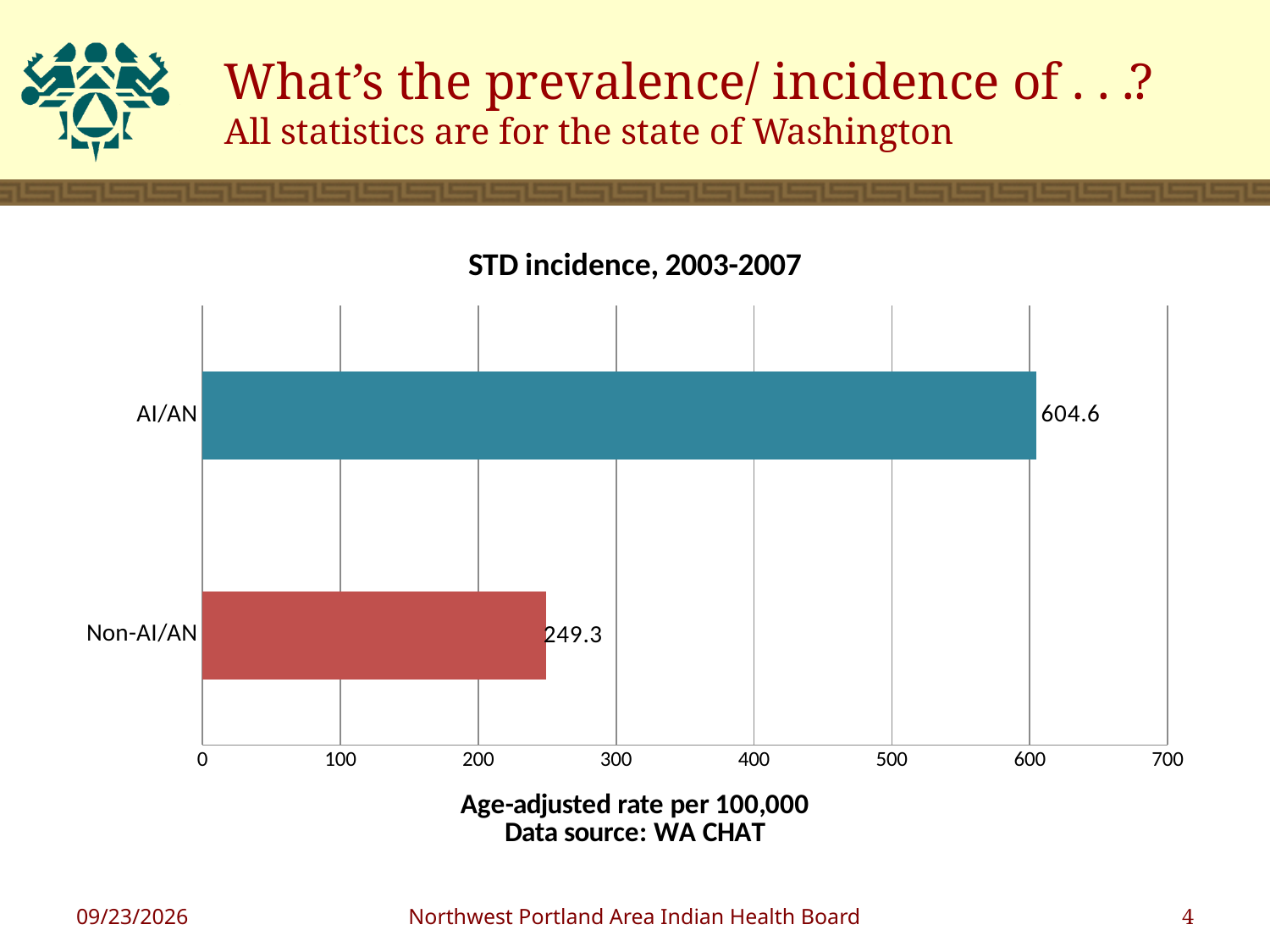
Is the STD incidence rate higher for AI/AN or Non-AI/AN? AI/AN Which group has the lower STD incidence rate? Non-AI/AN What kind of chart is shown on the slide? bar chart What is the STD incidence rate for Non-AI/AN? 249.3 Is the value for Non-AI/AN greater or less than 300? less What is the data source listed below the chart? WA CHAT What is the title of the chart? STD incidence, 2003-2007 Is the value for AI/AN greater or less than 500? greater Which group has the higher STD incidence rate? AI/AN What is the difference between the AI/AN and Non-AI/AN STD incidence rates? 355.3 What is the STD incidence rate for AI/AN? 604.6 How many categories are shown in the chart? 2